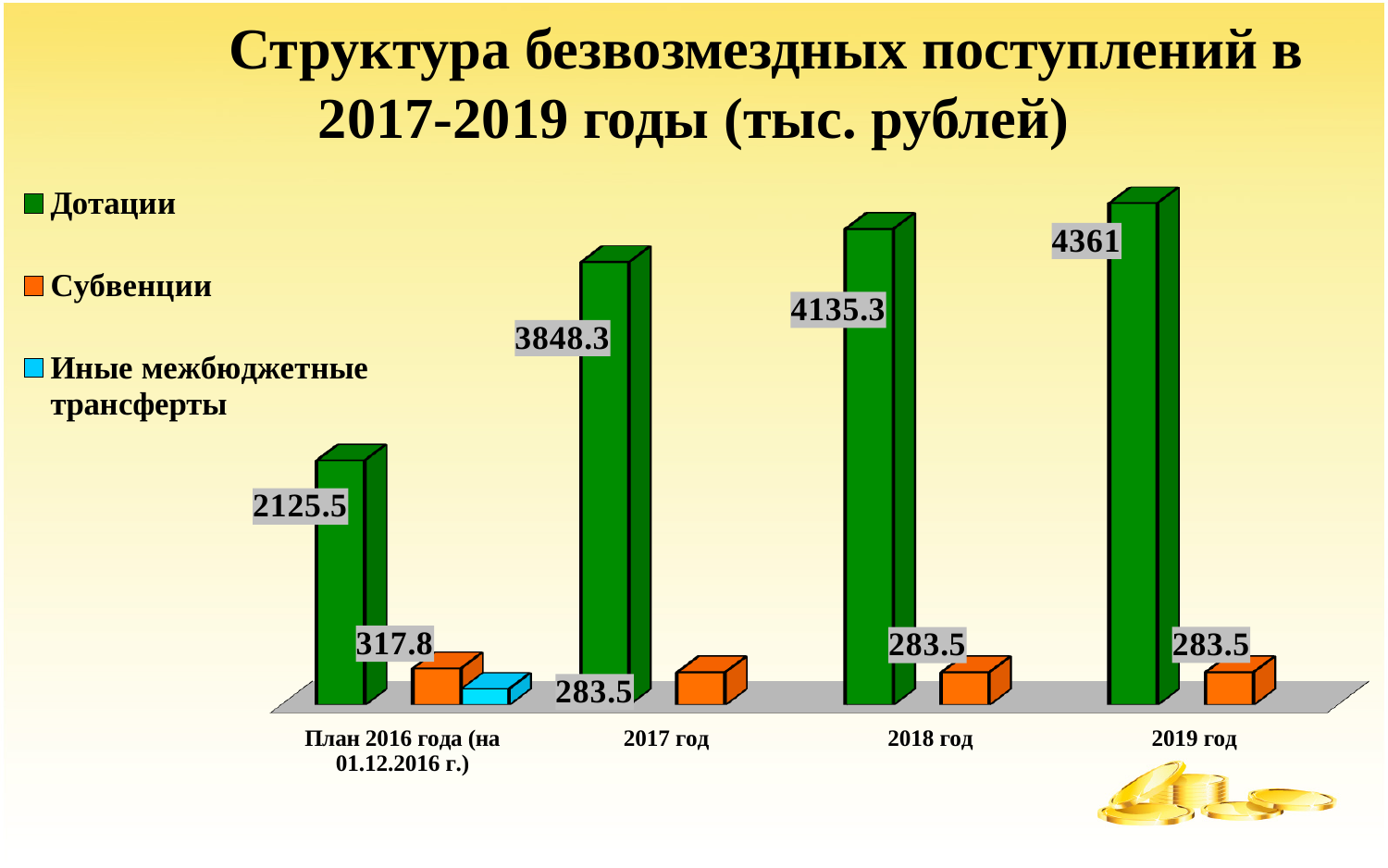
What is the difference between Дотации in 2017 год and План 2016 года (на 01.12.2016 г.)? 1722.8 What is the value of Дотации for 2019 год? 4361 Which is larger: Субвенции in План 2016 года (на 01.12.2016 г.) or Субвенции in 2017 год? План 2016 года (на 01.12.2016 г.) Do the Дотации values rise or fall from План 2016 года to 2019 год? rise What is the value of Субвенции for План 2016 года (на 01.12.2016 г.)? 317.8 In which category is Дотации lowest? План 2016 года (на 01.12.2016 г.) How many categories are shown on the x axis? 4 What is the value of Дотации for 2017 год? 3848.3 In which category is Дотации highest? 2019 год What is the difference between Дотации in 2019 год and 2018 год? 225.7 How many series does the legend list? 3 What is the value of Субвенции for 2018 год? 283.5